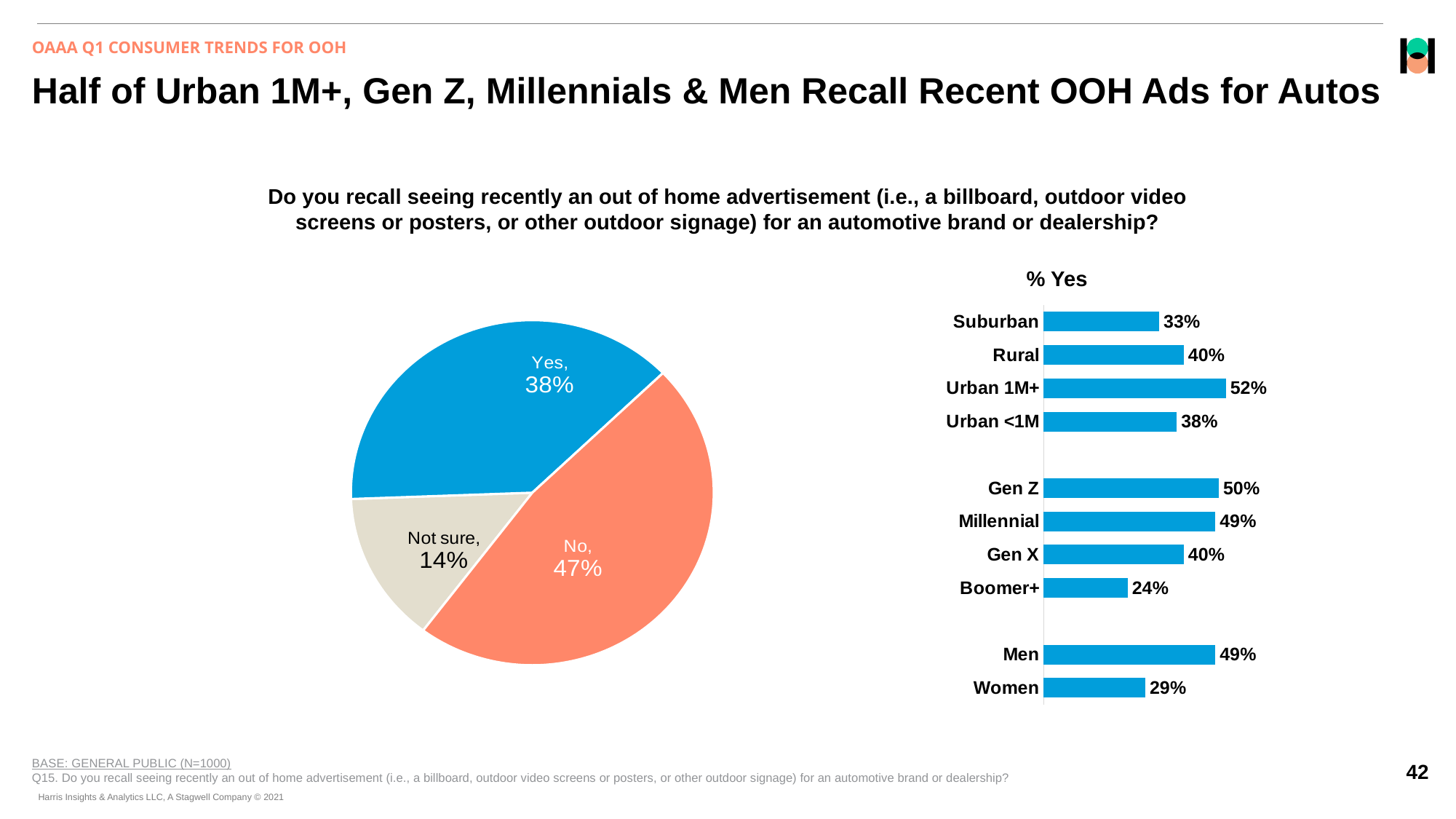
In the "% Yes" bar chart on the right, which category has the highest value? Urban 1M+ In the "% Yes" bar chart on the right, which category has the lowest value? Boomer+ In the "% Yes" bar chart on the right, what is the value for Boomer+? 24% In the pie chart on the left, how many slices are there? 3 What kind of chart is the "% Yes" chart on the right? Bar chart In the pie chart on the left, what percentage of respondents answered "Yes"? 38% In the pie chart on the left, what is the difference between the "No" and "Yes" shares? 9% In the "% Yes" bar chart on the right, what is the value for Urban 1M+? 52% In the "% Yes" bar chart on the right, what is the difference between Men and Women? 20% In the pie chart on the left, which response has the largest share? No In the pie chart on the left, what percentage of respondents answered "Not sure"? 14% In the "% Yes" bar chart on the right, which is larger, Rural or Suburban? Rural